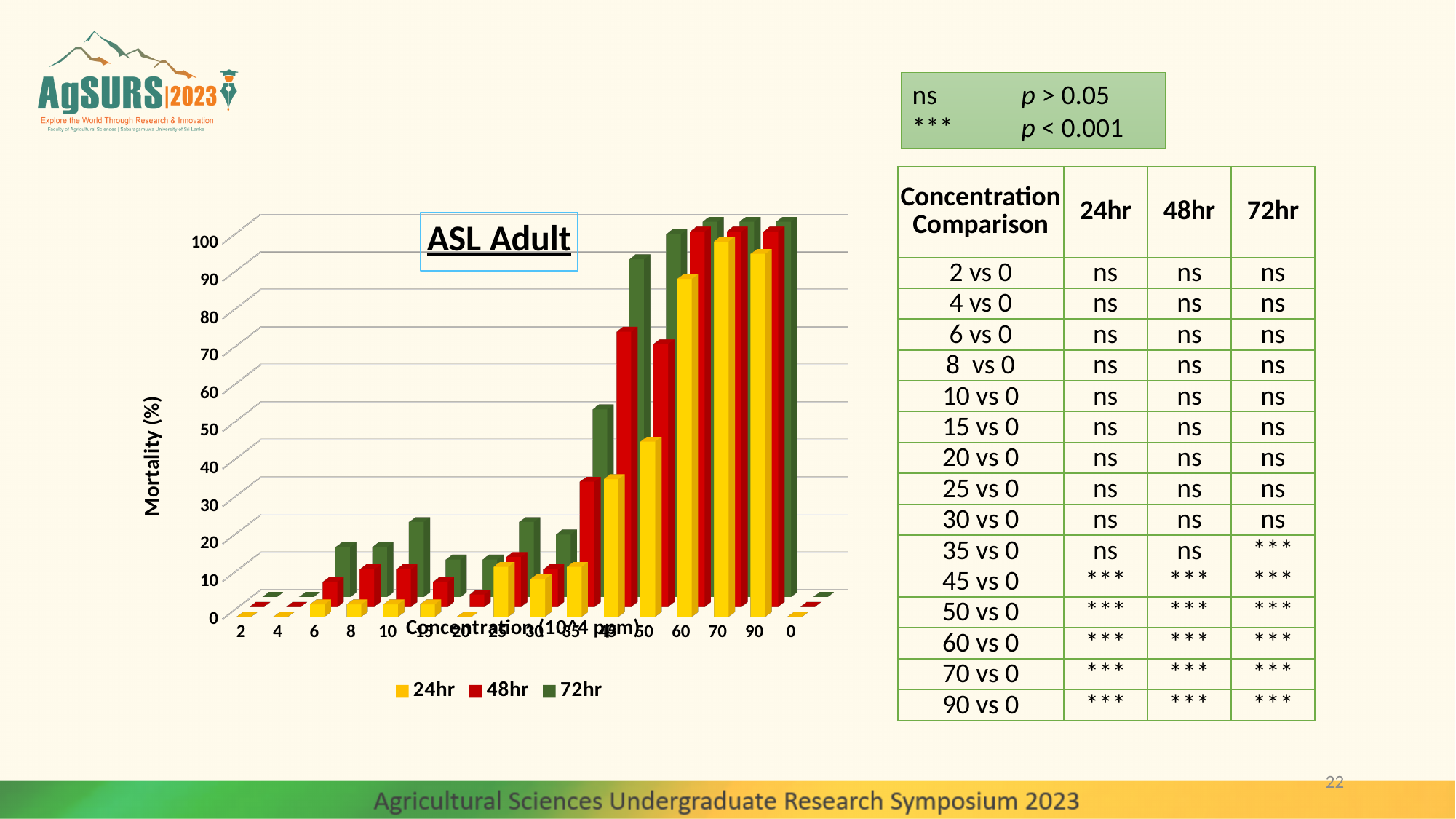
At concentration 45, which is larger, the 24hr value or the 72hr value? 72hr Is the 72hr value at concentration 60 greater or less than 90? greater What kind of chart is shown on the slide? bar chart How many series does the chart legend list? 3 What is the title of the chart? ASL Adult What is the label of the vertical axis of the chart? Mortality (%) Is the 72hr value at concentration 35 greater or less than 40? greater How many concentration categories are shown on the x axis of the chart? 16 Is the 24hr value at concentration 2 greater or less than 10? less Do the 72hr values generally rise or fall as concentration increases from 2 to 90? rise